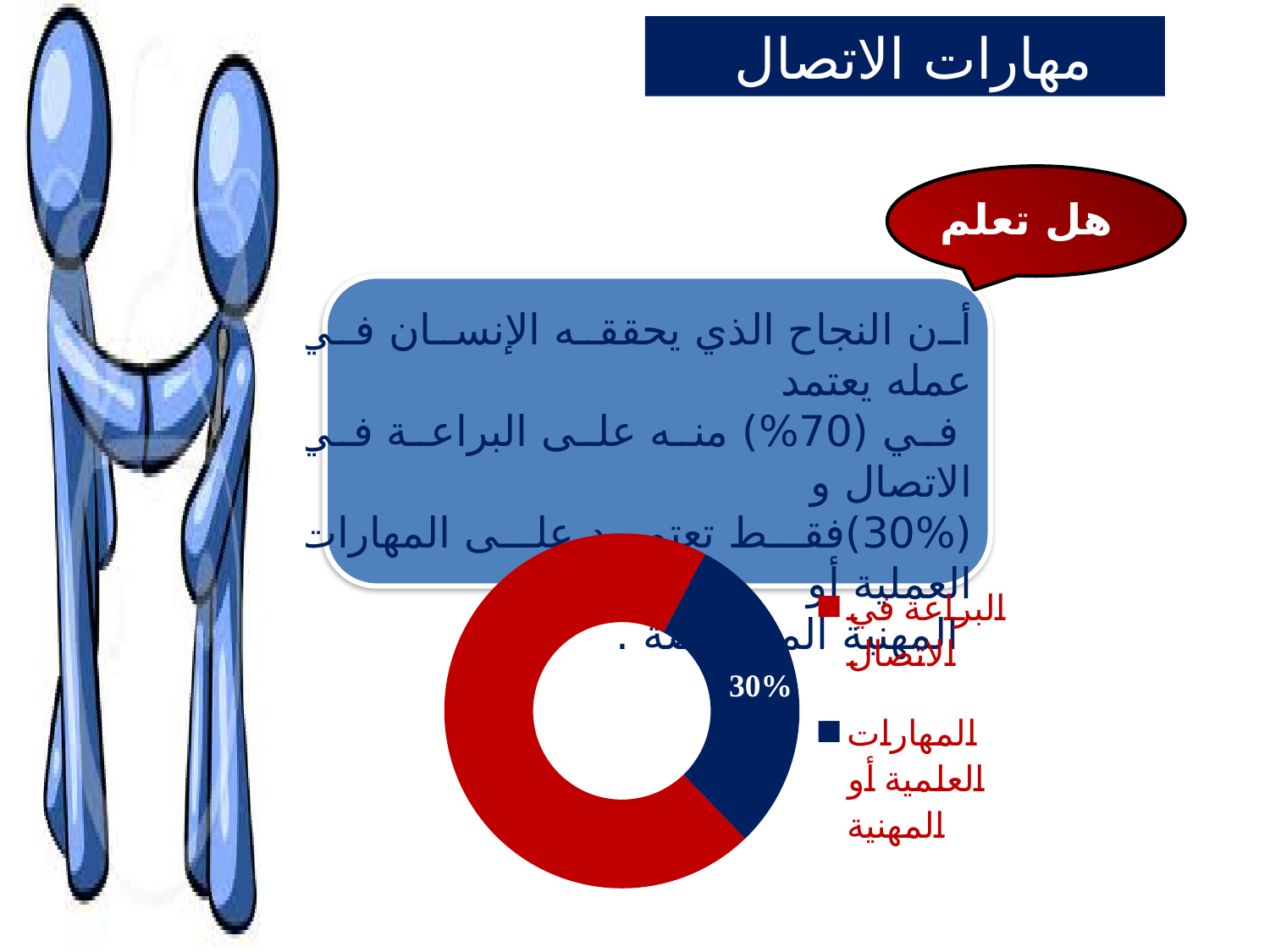
How many entries does the chart legend list? 2 What percentage is shown for المهارات العلمية أو المهنية in the doughnut chart? 30% What colour is the البراعة في الاتصال slice in the doughnut chart? red Is the share for المهارات العلمية أو المهنية greater or less than 50%? less What share of the doughnut does the المهارات العلمية أو المهنية slice represent? 30% Which category has the smallest slice in the doughnut chart? المهارات العلمية أو المهنية Which slice is larger, البراعة في الاتصال or المهارات العلمية أو المهنية? البراعة في الاتصال Which category has the largest slice in the doughnut chart? البراعة في الاتصال What kind of chart is shown on the slide? doughnut chart How many slices does the doughnut chart have? 2 What colour is the المهارات العلمية أو المهنية slice in the doughnut chart? blue